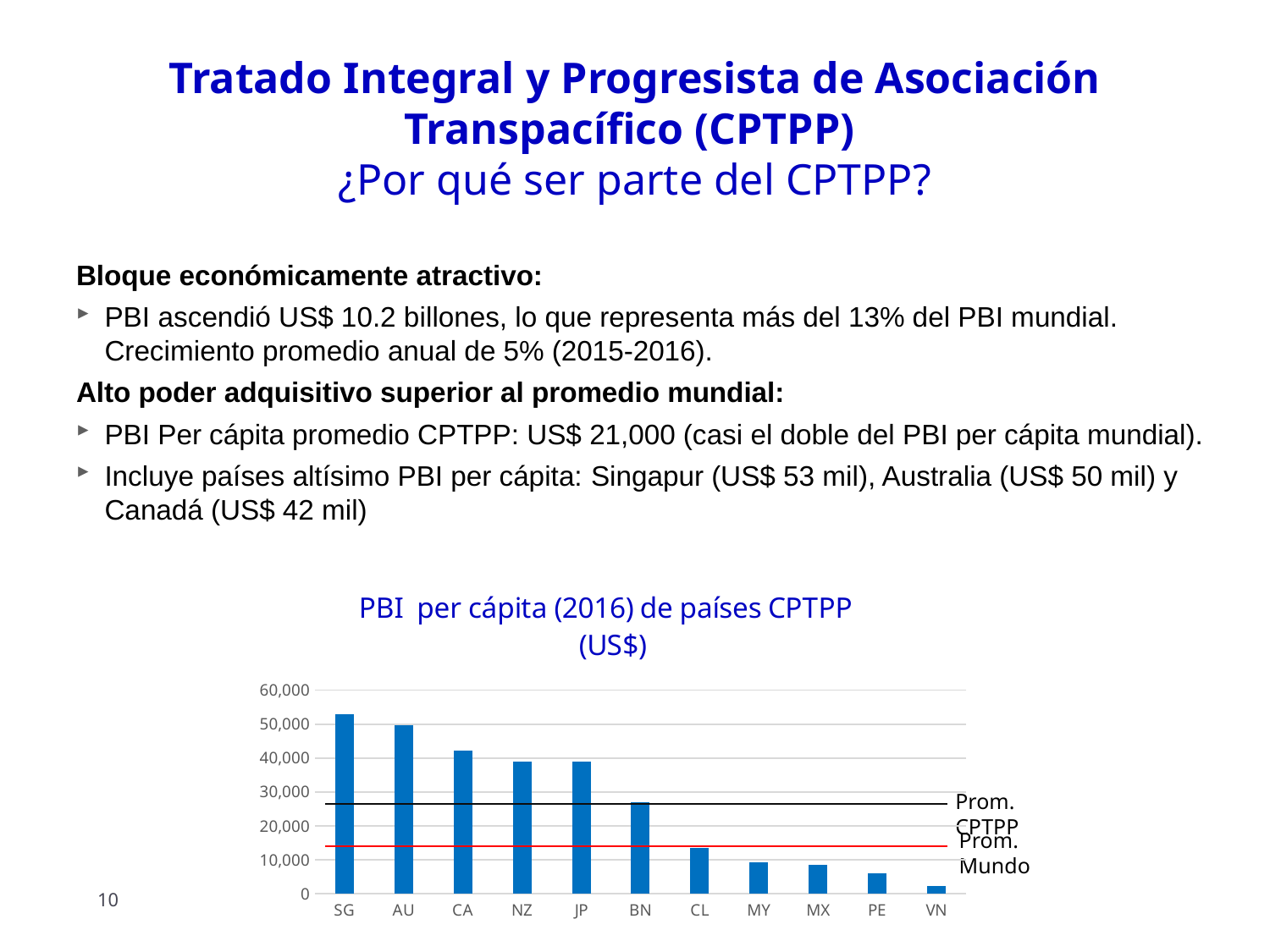
Is the value for BN greater or less than 30,000? less Is the value for VN greater or less than 10,000? less What do the two horizontal lines drawn across the chart represent? Prom. CPTPP and Prom. Mundo Which has a higher PBI per cápita, PE or MX? MX Which country has the lowest PBI per cápita in the chart? VN Which country has the highest PBI per cápita in the chart? SG Which has a higher PBI per cápita, SG or AU? SG Do the bar values rise or fall from left to right along the x axis? fall How many countries are plotted in the chart 'PBI per cápita (2016) de países CPTPP (US$)'? 11 What kind of chart is shown on the slide? bar chart Is the value for CA greater or less than 40,000? greater